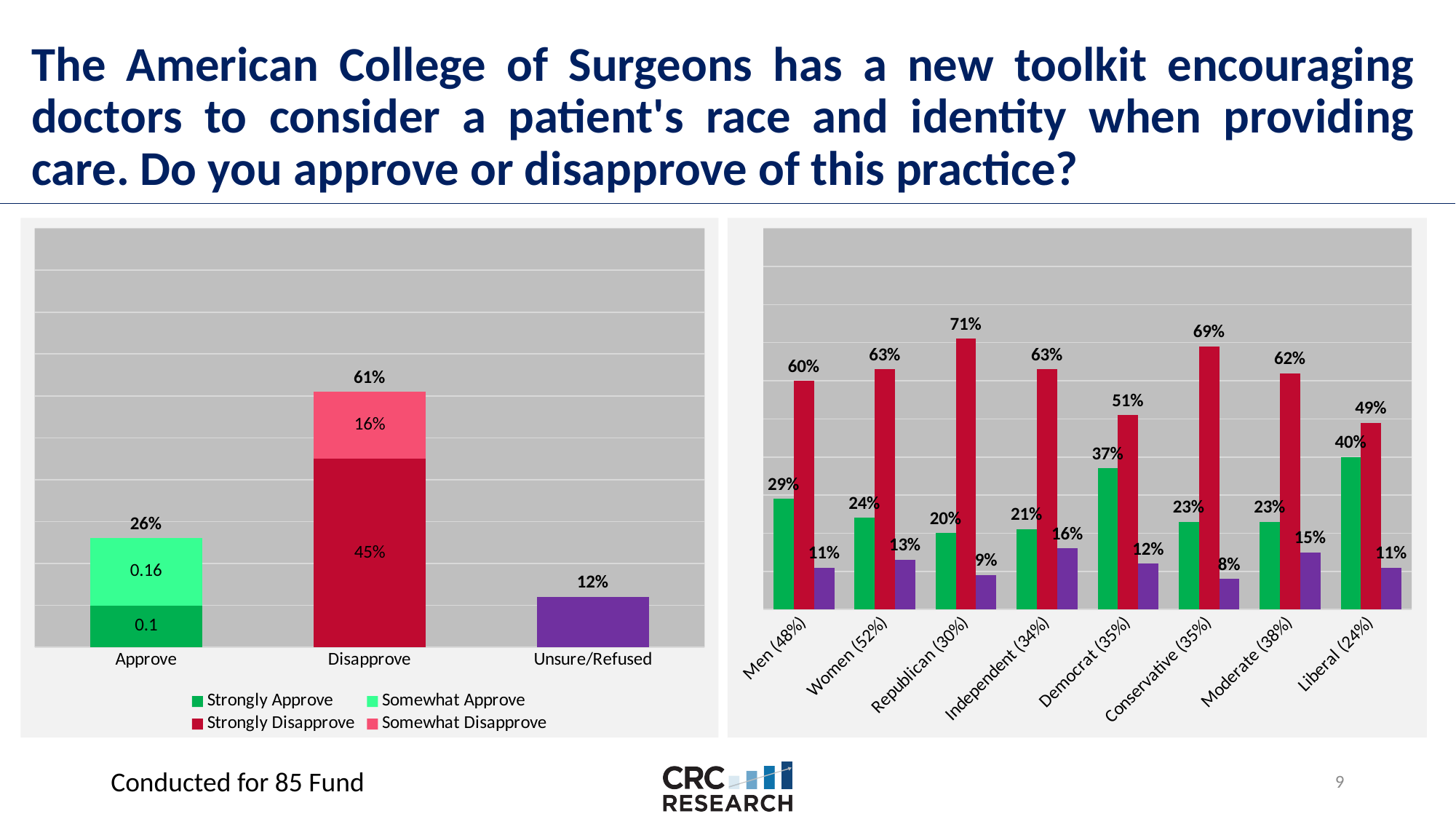
In the right chart, what is the value of the green bar for Liberal (24%)? 40% How many series does the legend of the left chart list? 4 How many groups are shown on the x axis of the right chart? 8 In the left chart, what value is printed on the Somewhat Disapprove segment of the Disapprove bar? 16% In the right chart, is the red bar for Democrat (35%) larger or smaller than the red bar for Conservative (35%)? Smaller In the right chart, which group has the lowest purple bar? Conservative (35%) In the right chart, what is the value of the tallest (red) bar for Republican (30%)? 71% In the left chart, what value is printed on the Strongly Approve segment of the Approve bar? 0.1 In the left chart, what is the total value shown above the Disapprove bar? 61% What kind of chart is the chart on the right? Bar chart In the left chart, which category has the lowest total value? Unsure/Refused In the left chart, what is the difference between the Disapprove total and the Approve total? 35%